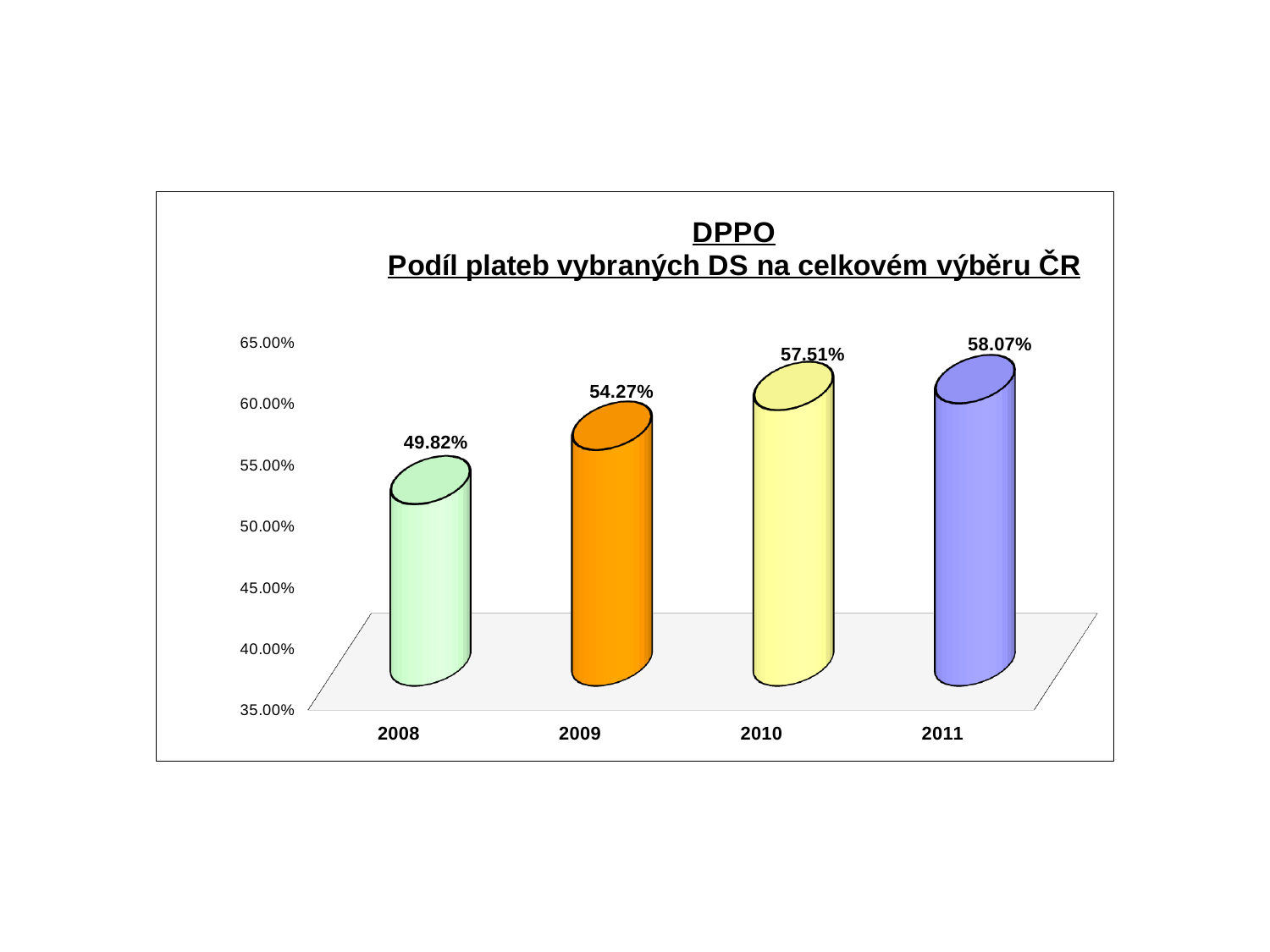
What is the difference between the values for 2009 and 2008? 4.45% What kind of chart is this? bar chart What is the value for 2008? 49.82% How many years are shown on the x axis? 4 Do the values rise or fall from 2008 to 2011? rise What is the value for 2011? 58.07% Which year has the highest value? 2011 What is the difference between the values for 2011 and 2010? 0.56% Which is larger, the value for 2010 or the value for 2009? 2010 What is the value for 2009? 54.27% What is the title of the chart? DPPO Podíl plateb vybraných DS na celkovém výběru ČR Which year has the lowest value? 2008